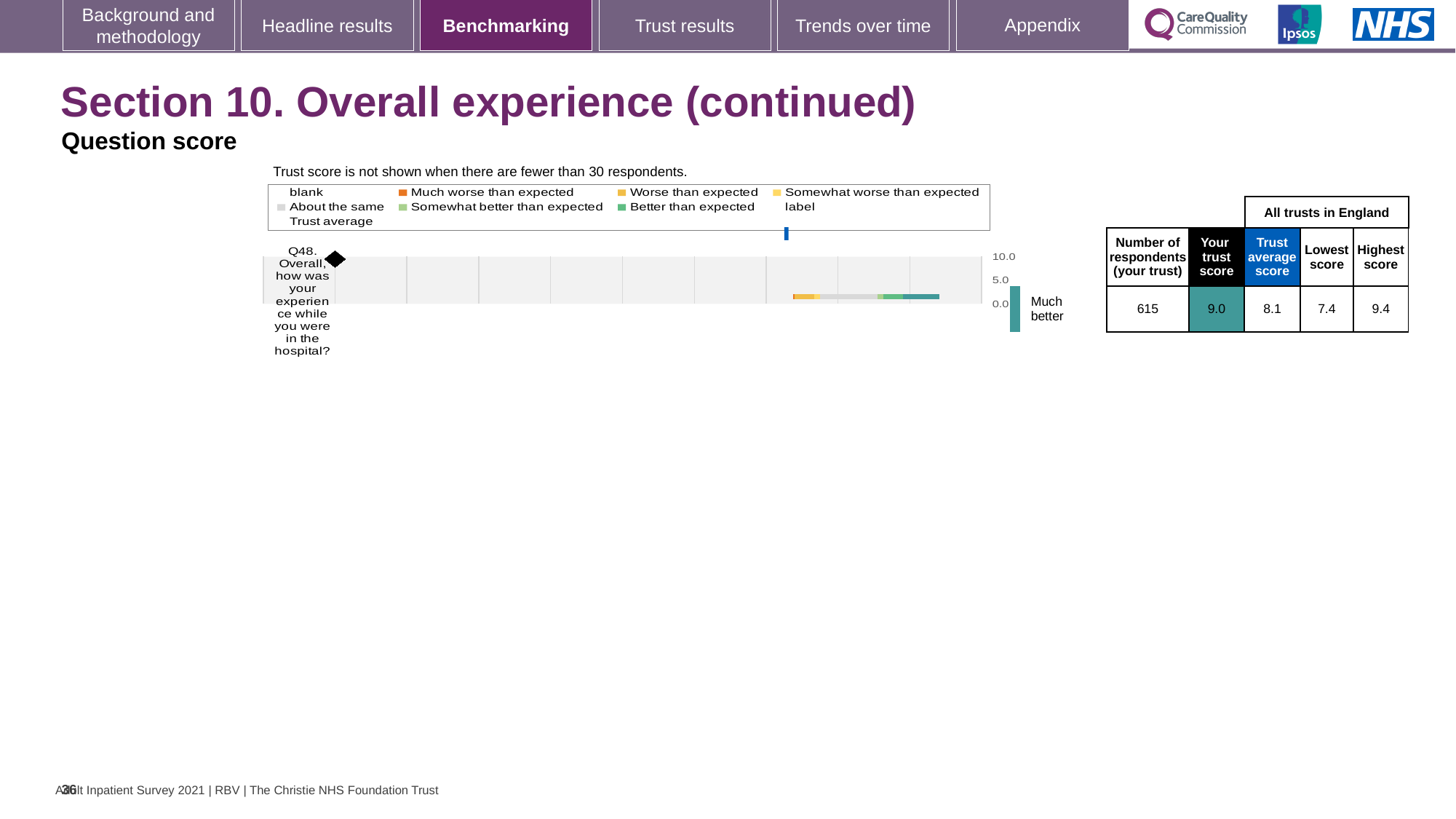
How many survey questions are plotted on the chart? 1 What is the lowest score for Q48 among all trusts in England? 7.4 What is the 'Your trust score' for Q48 shown in the table? 9.0 Which legend entry is shown with the dark green colour? Better than expected How many respondents from your trust answered Q48? 615 What is the trust average score for Q48 across all trusts in England? 8.1 What kind of chart is used to show the Q48 benchmarking result? Bar chart According to the note above the chart, when is the trust score not shown? When there are fewer than 30 respondents What is the difference between the highest score and the lowest score for Q48? 2.0 Which is larger for Q48: your trust score or the trust average score? Your trust score What is the highest score for Q48 among all trusts in England? 9.4 By how much does your trust score exceed the trust average score for Q48? 0.9